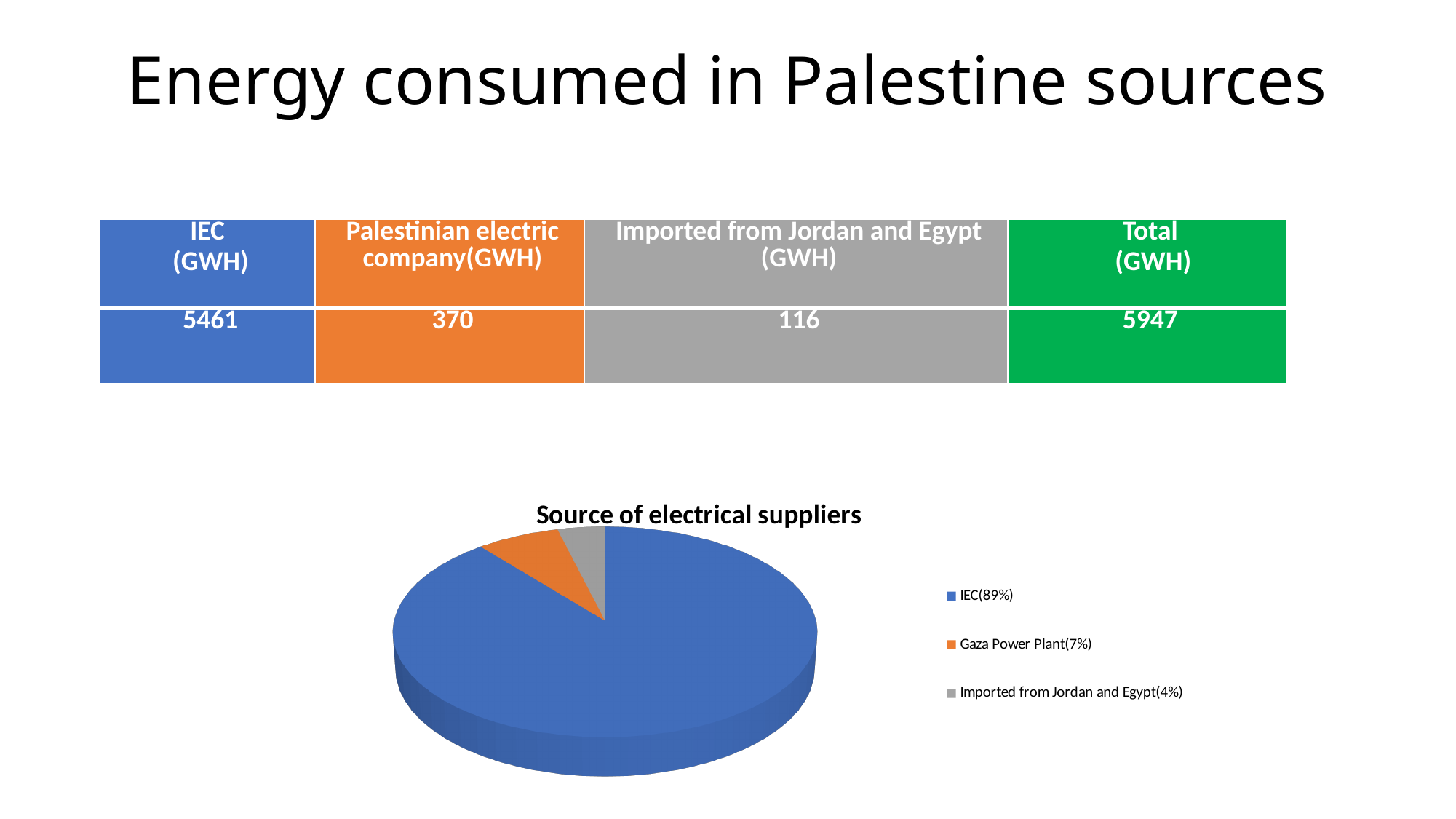
How many slices does the pie chart have? 3 According to the pie chart legend, what share of the pie does IEC represent? 89% In the pie chart, which is larger: the Gaza Power Plant slice or the Imported from Jordan and Egypt slice? Gaza Power Plant Which slice of the pie chart is the smallest? Imported from Jordan and Egypt(4%) What kind of chart is shown under the title "Source of electrical suppliers"? pie chart How many entries does the pie chart's legend list? 3 What colour is the IEC slice in the pie chart? blue Which slice of the pie chart is the largest? IEC(89%) According to the pie chart legend, what share of the pie does Imported from Jordan and Egypt represent? 4% What is the difference in percentage points between the IEC share and the Gaza Power Plant share in the pie chart? 82 According to the pie chart legend, what share of the pie does Gaza Power Plant represent? 7% What is the title of the pie chart? Source of electrical suppliers